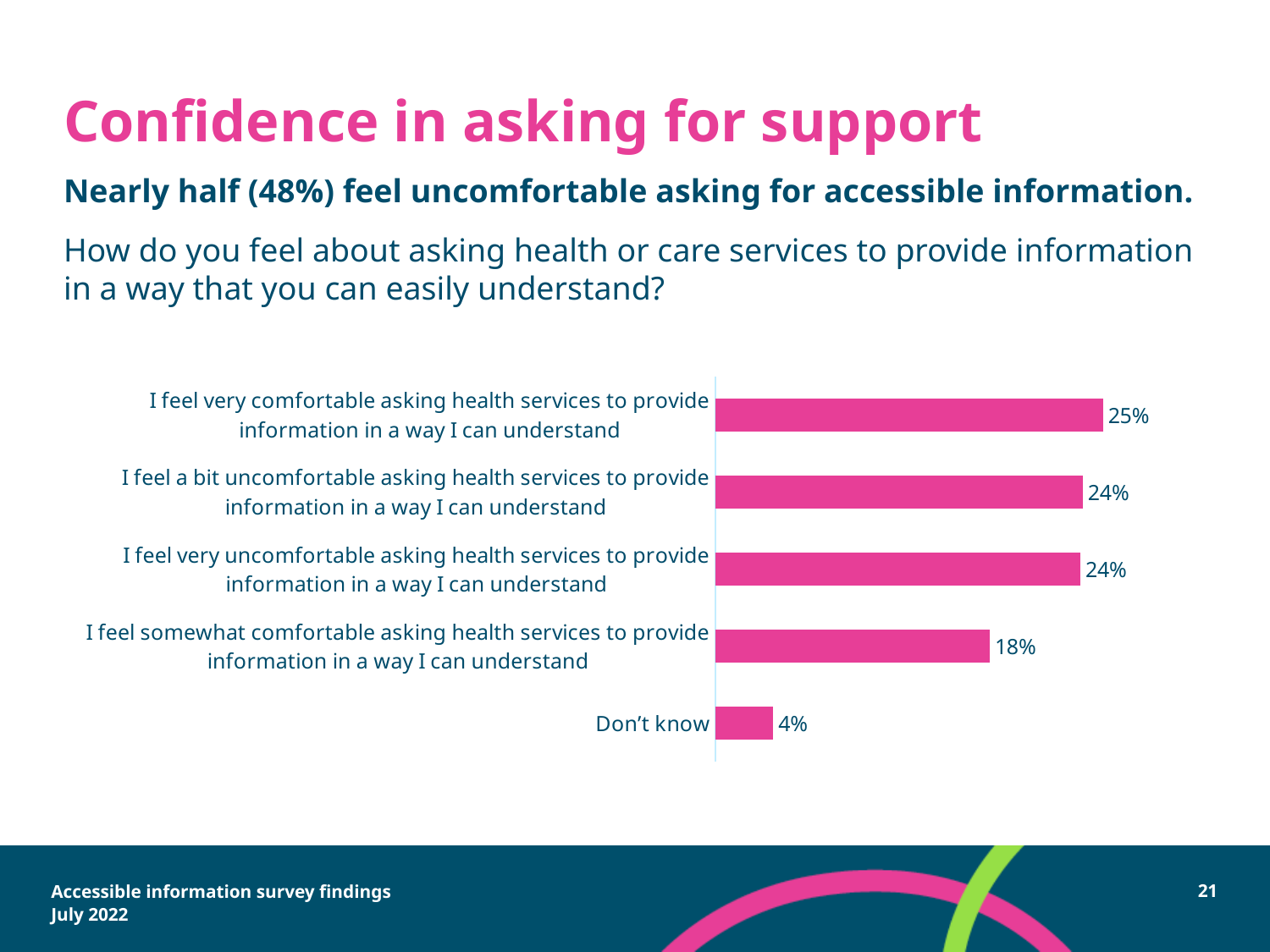
Which is larger: the percentage for "I feel somewhat comfortable" or the percentage for "Don't know"? I feel somewhat comfortable What is the difference in percentage points between "I feel very comfortable" and "I feel somewhat comfortable"? 7 Which response category has the lowest percentage? Don't know Which response category has the highest percentage? I feel very comfortable asking health services to provide information in a way I can understand What percentage of respondents said they feel very uncomfortable asking health services to provide information in a way they can understand? 24% What colour are the bars in the chart? Pink How many response categories are shown in the chart? 5 What kind of chart is shown on the slide? Bar chart What percentage of respondents answered "Don't know"? 4% What is the difference in percentage points between "I feel a bit uncomfortable" and "Don't know"? 20 What percentage of respondents said they feel very comfortable asking health services to provide information in a way they can understand? 25% What percentage of respondents said they feel somewhat comfortable asking health services to provide information in a way they can understand? 18%